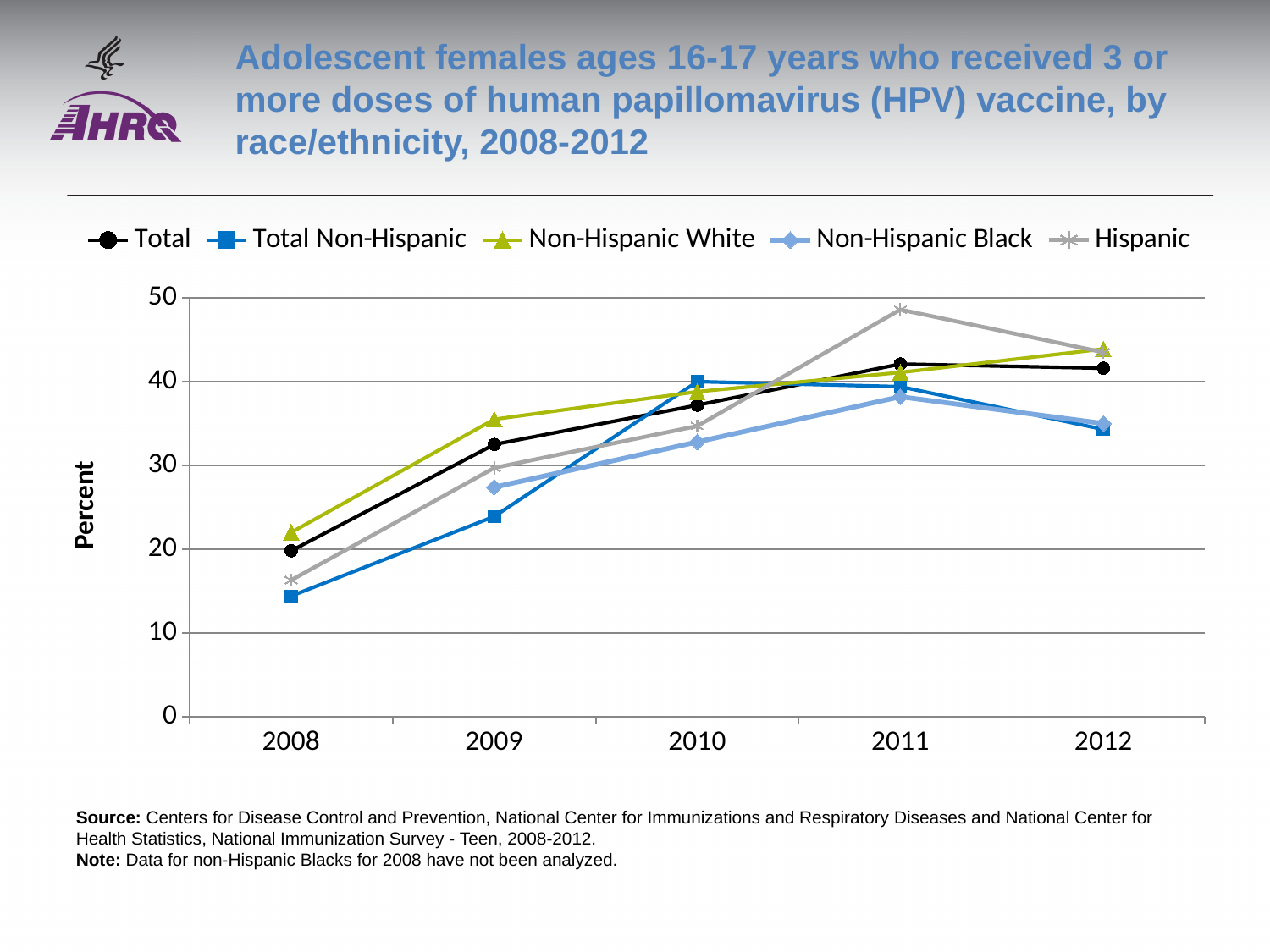
In 2012, which is larger: Non-Hispanic White or Total Non-Hispanic? Non-Hispanic White Which series has the highest value in 2011? Hispanic Does the Hispanic series rise or fall from 2011 to 2012? fall Is the value for Non-Hispanic Black in 2010 greater or less than 30? greater How many series does the legend list? 5 Does the Total series rise or fall from 2008 to 2011? rise Which series has the lowest value in 2009? Total Non-Hispanic What kind of chart is shown on the slide? line chart Is the value for Total Non-Hispanic in 2008 greater or less than 20? less How many years are shown on the x axis? 5 Is the value for Hispanic in 2011 greater or less than 40? greater Which series has no data point plotted for 2008? Non-Hispanic Black